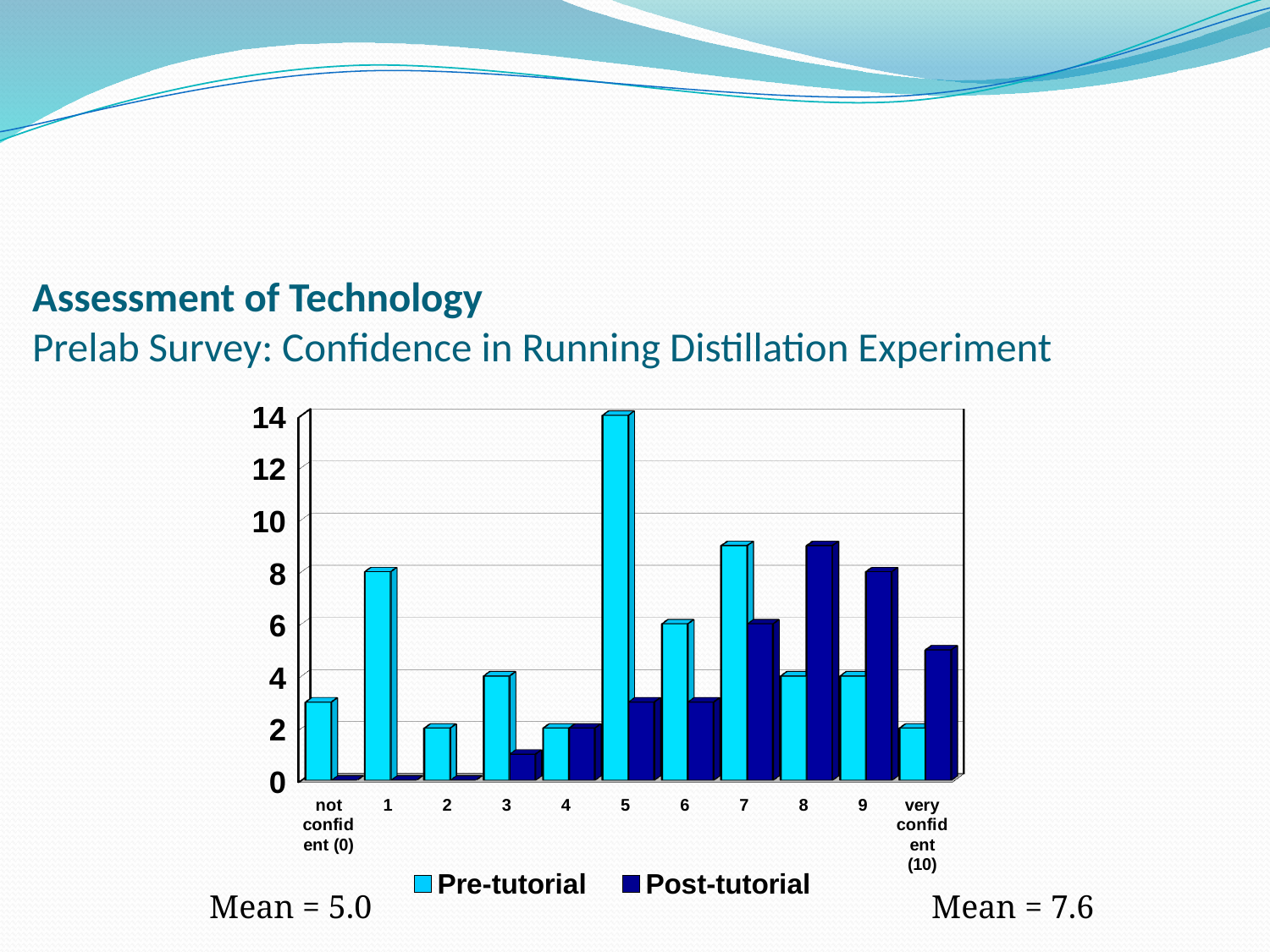
For category 5, which series has the larger value, Pre-tutorial or Post-tutorial? Pre-tutorial How many confidence categories are shown along the x axis? 11 What kind of chart is shown on the slide? bar chart Which category has the highest Pre-tutorial value? 5 How many series does the legend list? 2 What is the Pre-tutorial value for category 5? 14 Is the Post-tutorial value for category 3 greater or less than 2? less What are the two series named in the legend? Pre-tutorial and Post-tutorial Is the Post-tutorial value for category 9 greater or less than 6? greater For category 8, which series has the larger value, Pre-tutorial or Post-tutorial? Post-tutorial Is the Pre-tutorial value for category 1 greater or less than 6? greater Which category has the highest Post-tutorial value? 8